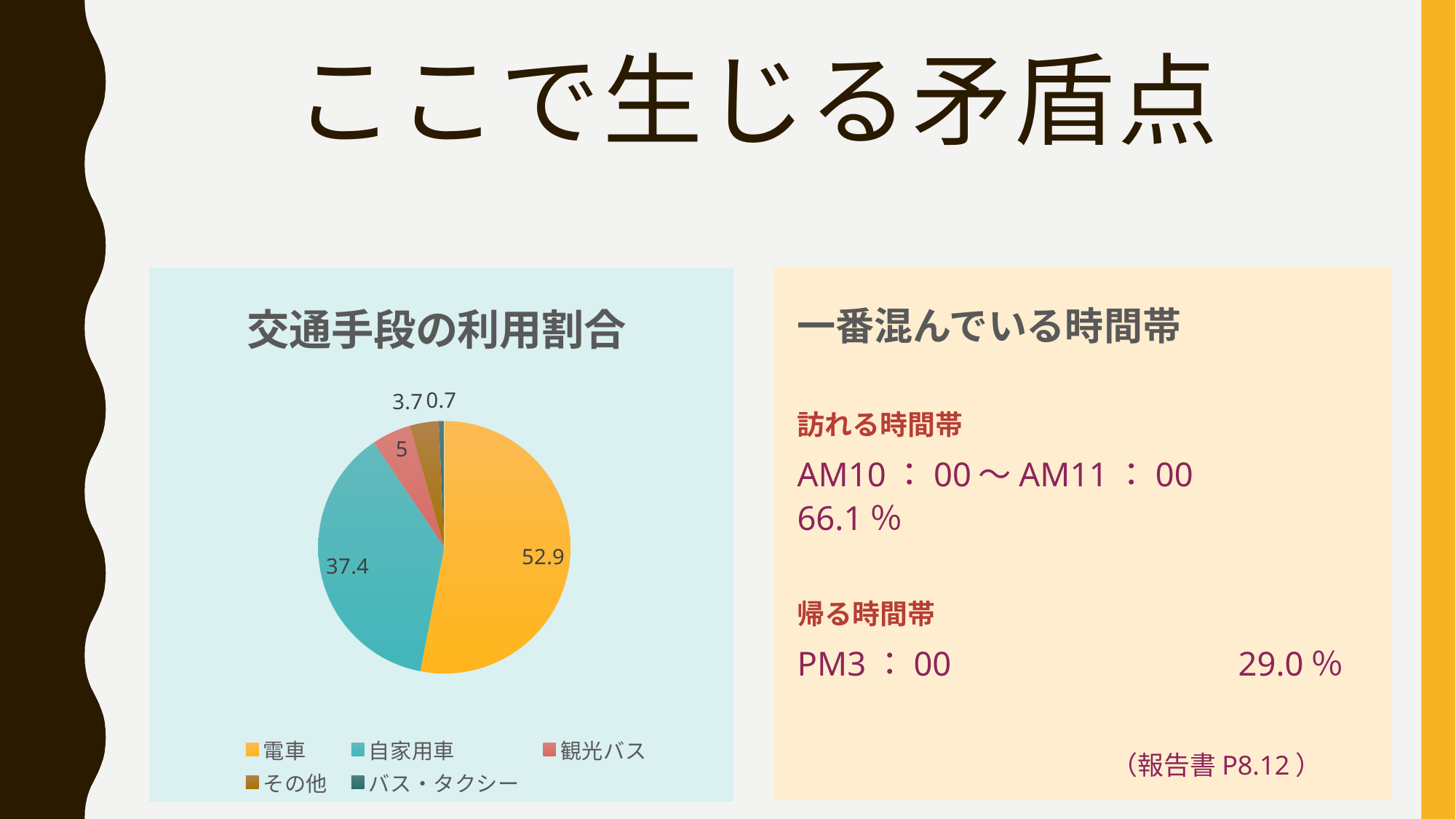
What type of chart is shown on the slide? pie chart Which category has the largest slice in the pie chart? 電車 What is the value for 観光バス in the pie chart? 5 What is the title of the chart? 交通手段の利用割合 How many categories does the legend of the pie chart list? 5 Which is larger, the value for 観光バス or the value for その他? 観光バス What is the value for バス・タクシー in the pie chart? 0.7 What is the difference between the values for 電車 and 自家用車? 15.5 What is the value for その他 in the pie chart? 3.7 What is the value for 自家用車 in the pie chart? 37.4 What is the value for 電車 in the pie chart? 52.9 Which category has the smallest slice in the pie chart? バス・タクシー